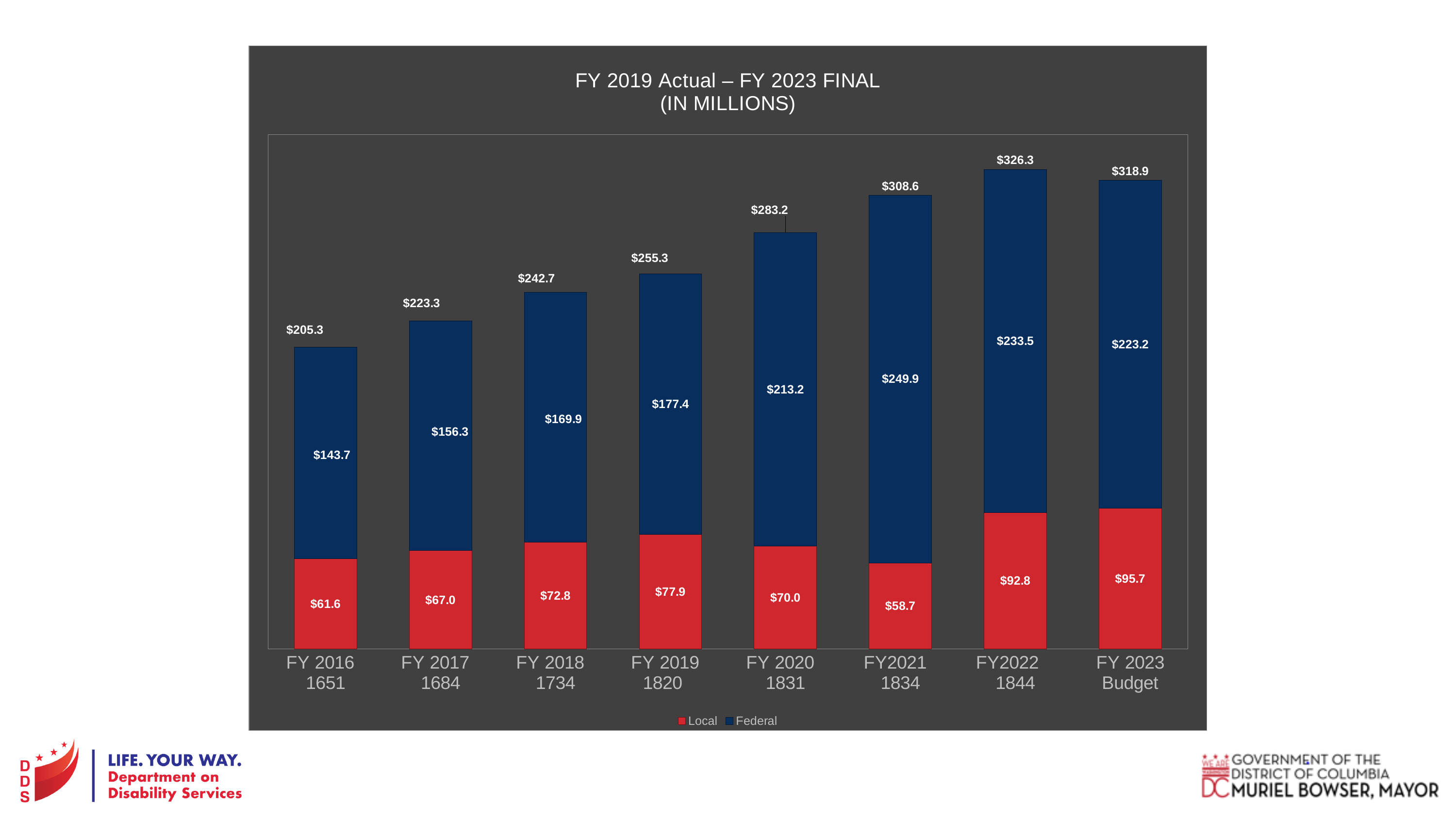
What colour represents the Local series? red Which category has the highest total? FY2022 1844 Which category has the lowest Local value? FY2021 1834 How many series does the legend list? 2 What is the difference between the Federal values for FY 2017 1684 and FY 2016 1651? $12.6 How many categories are shown on the x axis? 8 Do the Federal values rise or fall from FY 2016 1651 to FY2022 1844? rise What is the total shown above the FY 2020 1831 bar? $283.2 What is the Local value for FY 2019 1820? $77.9 What kind of chart is this? stacked bar chart Which is larger, the Local value for FY 2023 Budget or the Local value for FY2022 1844? FY 2023 Budget What is the Federal value for FY2022 1844? $233.5